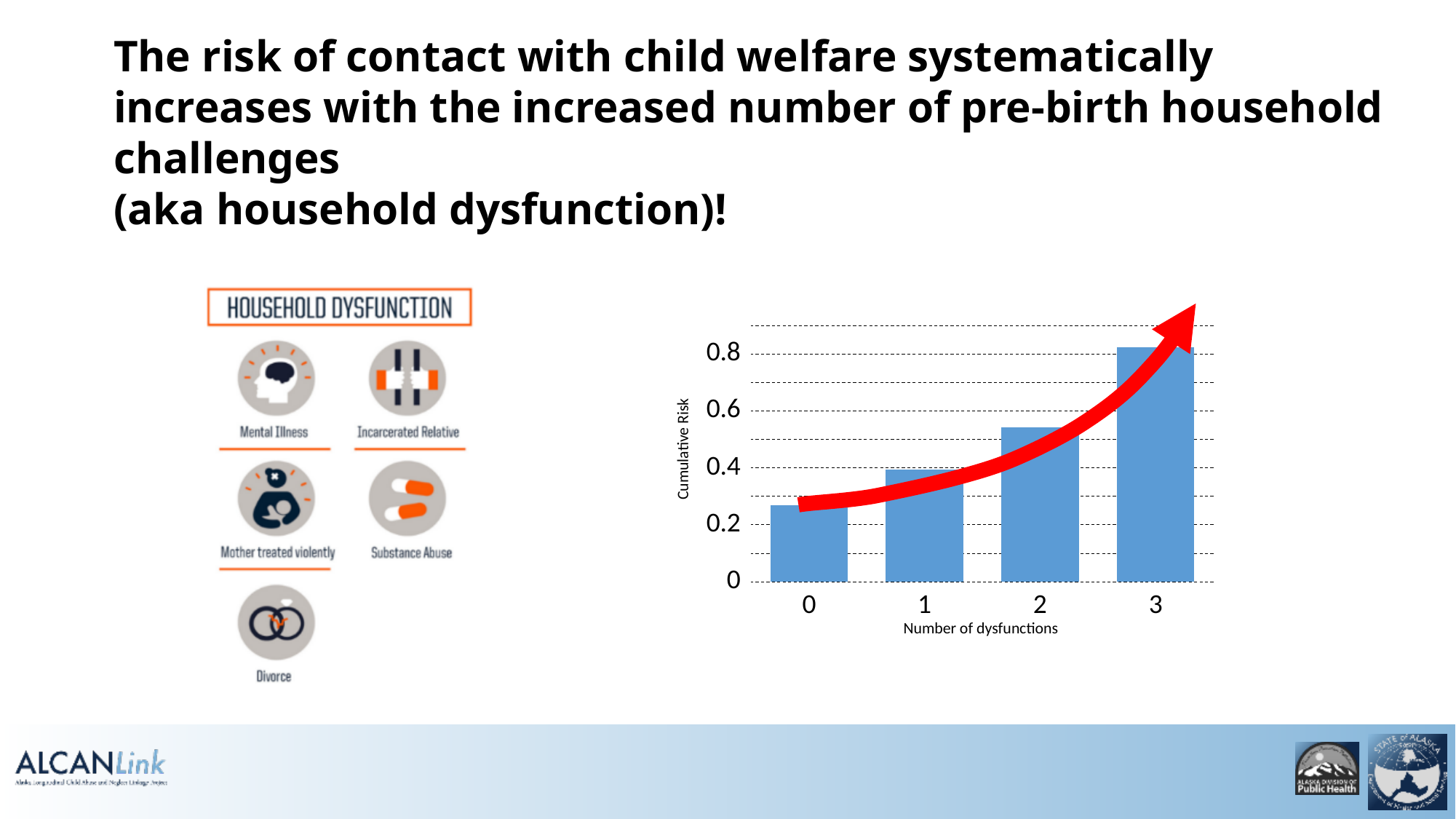
What is the label of the y axis of the chart? Cumulative Risk Is the cumulative risk for 0 dysfunctions greater or less than 0.2? greater Which number of dysfunctions has the lowest cumulative risk? 0 Which has a larger cumulative risk: 1 dysfunction or 3 dysfunctions? 3 dysfunctions What kind of chart is shown on the slide? bar chart What is the label of the x axis of the chart? Number of dysfunctions Which number of dysfunctions has the highest cumulative risk? 3 Do the cumulative risk values rise or fall as the number of dysfunctions increases? rise Is the cumulative risk for 2 dysfunctions greater or less than 0.4? greater Is the cumulative risk for 3 dysfunctions greater or less than 0.6? greater How many bars (categories) are plotted in the chart? 4